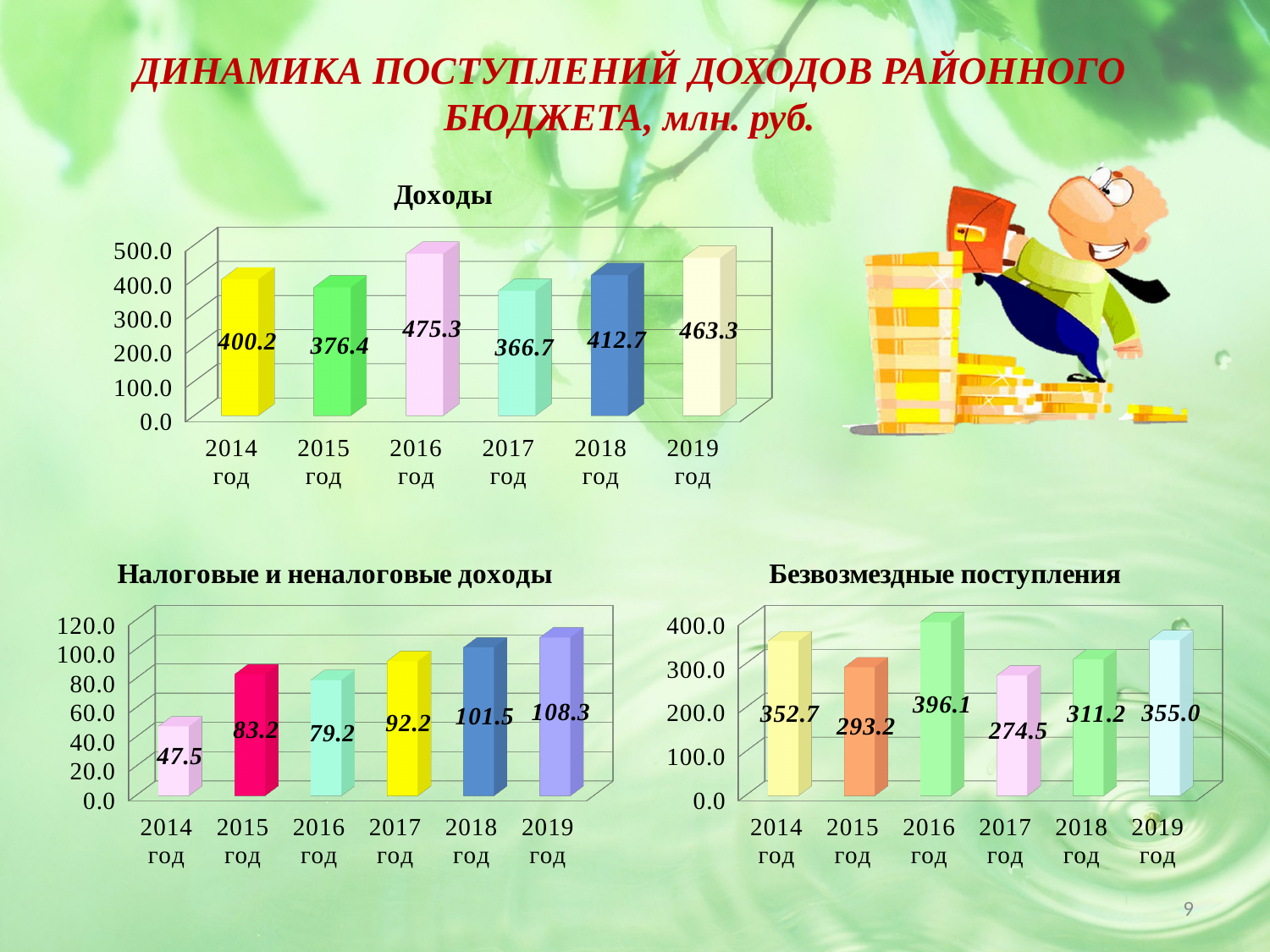
In the 'Безвозмездные поступления' chart, what is the value for 2017 год? 274.5 In the 'Налоговые и неналоговые доходы' chart, which year has the highest value? 2019 год In the 'Доходы' chart, what is the difference between the values for 2019 год and 2018 год? 50.6 In the 'Налоговые и неналоговые доходы' chart, which is larger, the value for 2015 год or 2016 год? 2015 год In the 'Доходы' chart, which year has the lowest value? 2017 год In the 'Безвозмездные поступления' chart, which year has the highest value? 2016 год In the 'Безвозмездные поступления' chart, is the value for 2015 год greater or less than 300.0? less In the 'Налоговые и неналоговые доходы' chart, what is the value for 2014 год? 47.5 What kind of chart is the 'Безвозмездные поступления' chart? bar chart In the 'Доходы' chart, how many years are plotted? 6 In the 'Налоговые и неналоговые доходы' chart, what is the difference between the values for 2018 год and 2017 год? 9.3 In the 'Доходы' chart, what is the value for 2016 год? 475.3